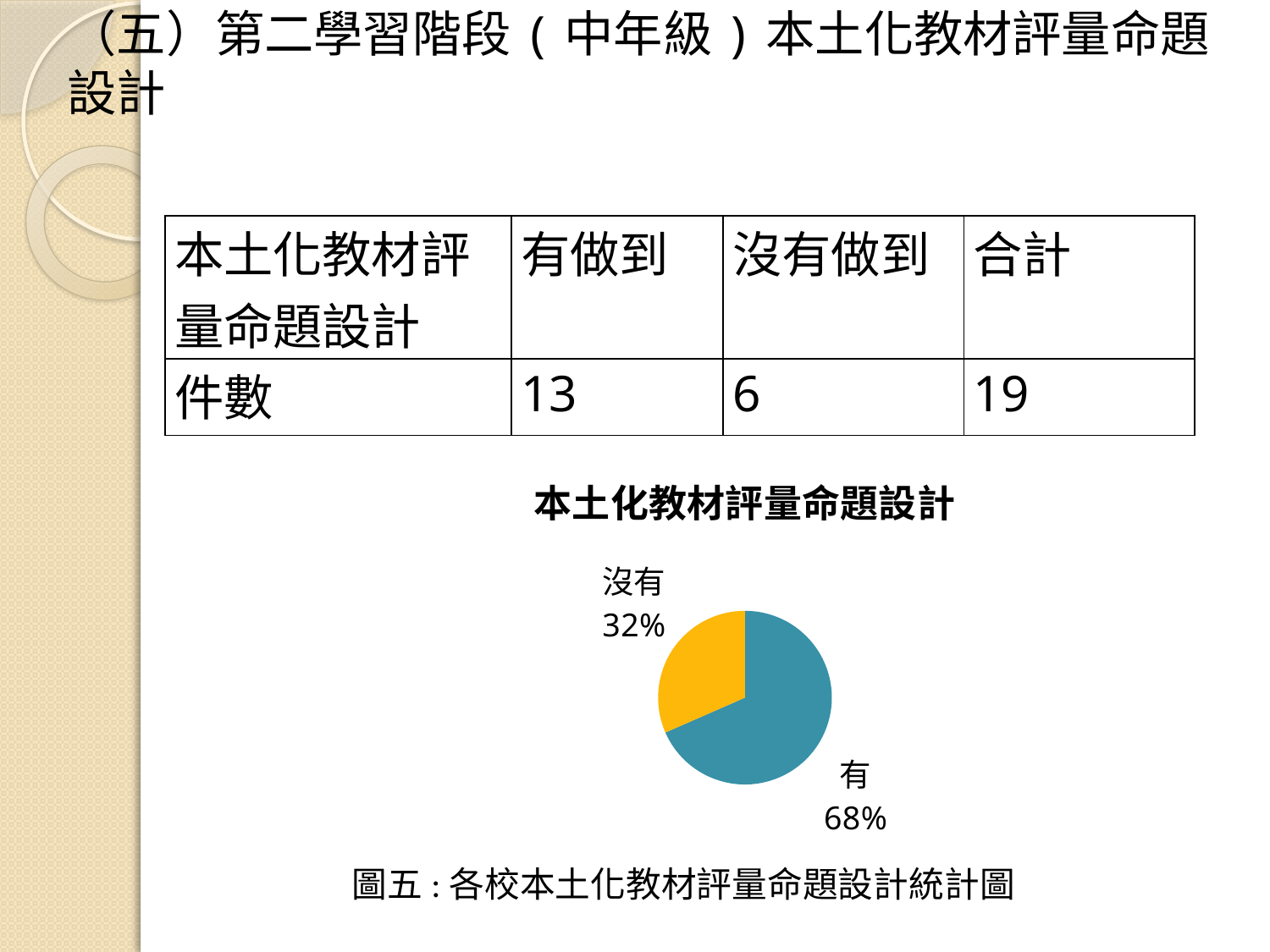
What is the title of the pie chart? 本土化教材評量命題設計 What is the difference in percentage points between the 有 and 沒有 slices? 36% Which slice of the pie chart is the largest? 有 What colour is the 沒有 slice in the pie chart? yellow/orange Is the share for 有 greater or less than 50%? greater What share of the pie does the 有 slice represent? 68% What share of the pie does the 沒有 slice represent? 32% How many slices does the pie chart have? 2 What kind of chart is shown on the slide? pie chart Which is larger in the pie chart, 有 or 沒有? 有 Which slice of the pie chart is the smallest? 沒有